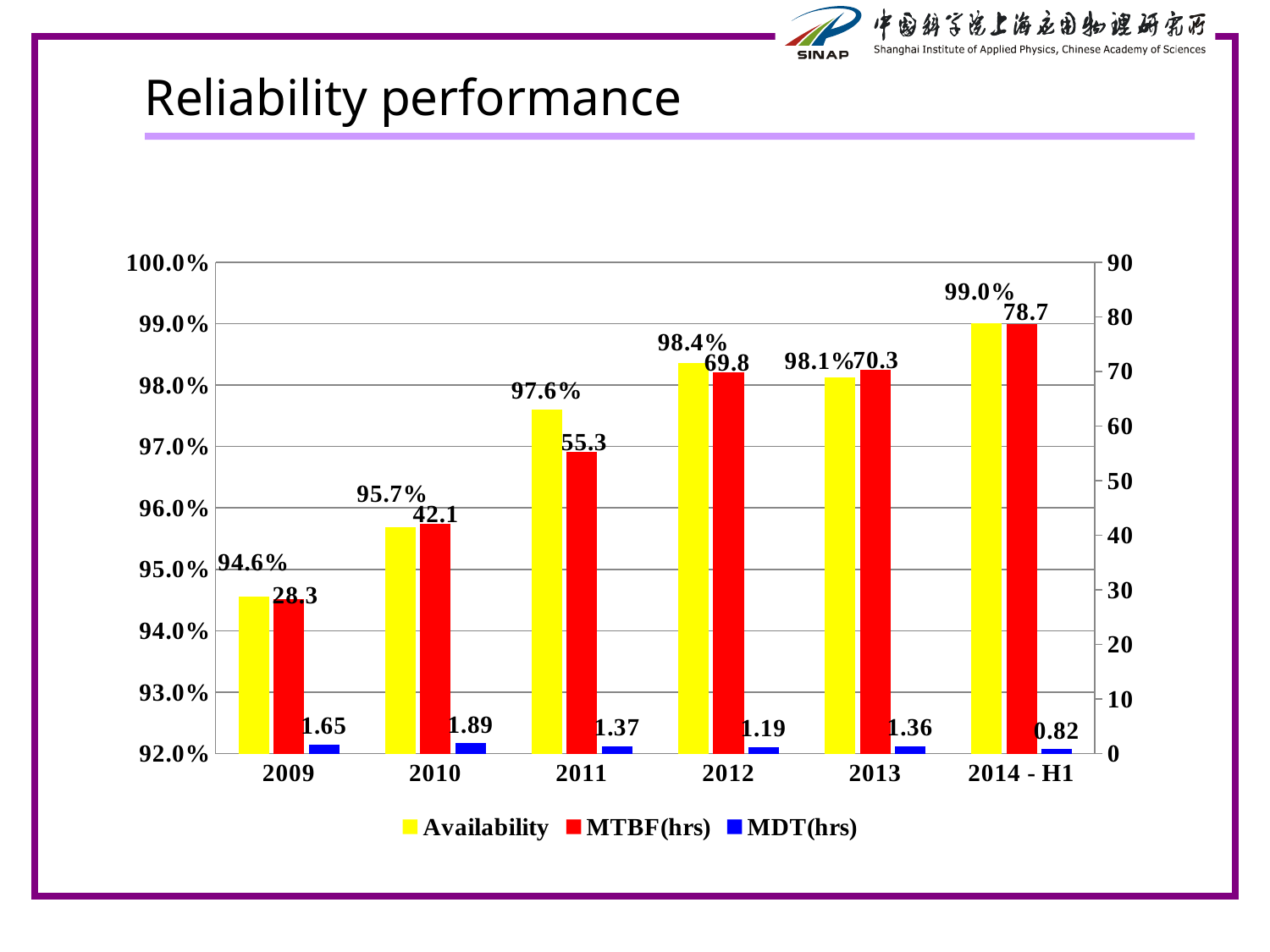
What kind of chart is shown on the slide? bar chart Which year has the lowest MDT(hrs) value? 2014 - H1 Does the MTBF(hrs) value rise or fall from 2009 to 2014 - H1? rise How many categories are shown on the x axis? 6 Which year has the lowest Availability value? 2009 Which is larger, the Availability value for 2012 or for 2013? 2012 What is the MTBF(hrs) value for 2012? 69.8 What is the Availability value for 2011? 97.6% How many series does the legend list? 3 Which year has the highest MTBF(hrs) value? 2014 - H1 What is the difference in MTBF(hrs) between 2014 - H1 and 2009? 50.4 What is the MDT(hrs) value for 2010? 1.89